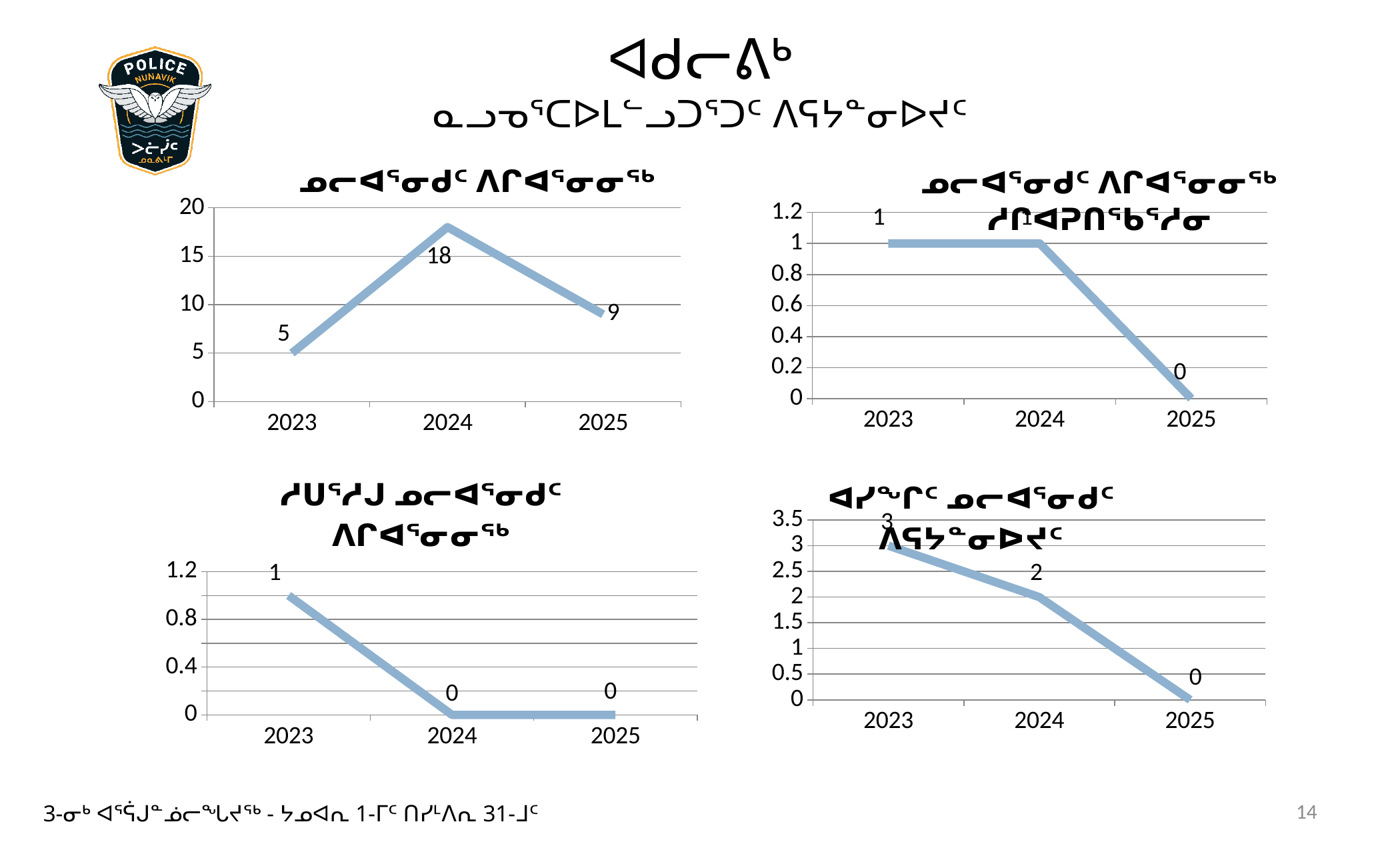
In the bottom-left chart, what is the value for 2023? 1 What kind of chart is the bottom-right chart? line chart In the top-left chart, which year has the lowest value? 2023 In the top-left chart, what is the value for 2023? 5 In the top-right chart, what is the value for 2025? 0 In the top-left chart, what is the difference between the values for 2024 and 2025? 9 In the top-left chart, what is the value for 2024? 18 In the bottom-right chart, do the values rise or fall from 2023 to 2025? fall In the bottom-right chart, what is the value for 2024? 2 In the top-left chart, which year has the highest value? 2024 In the bottom-left chart, how many years are plotted on the x axis? 3 In the top-right chart, is the value for 2023 larger or smaller than the value for 2025? larger